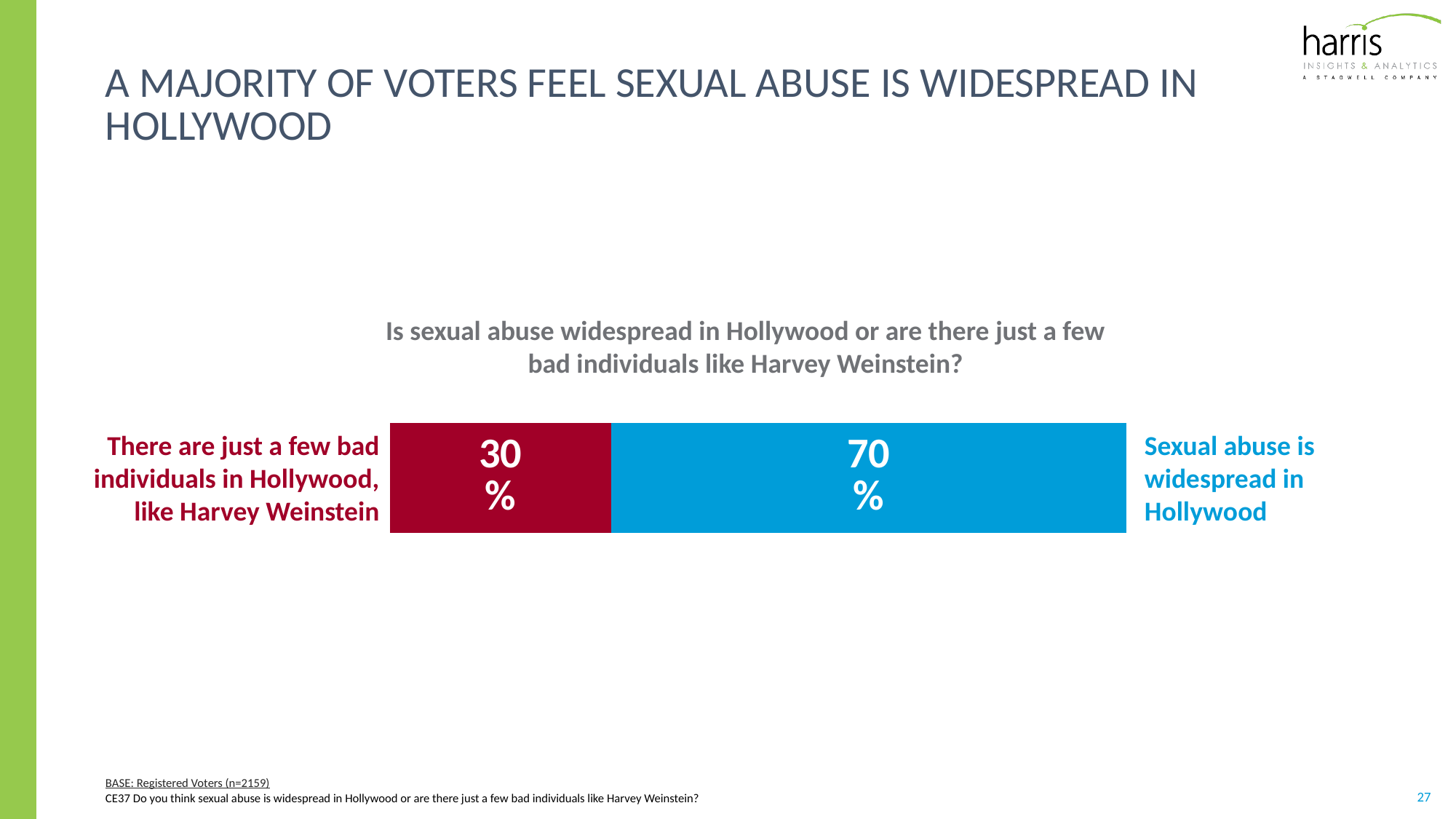
What percentage of voters say sexual abuse is widespread in Hollywood? 70% What question is the chart titled with? Is sexual abuse widespread in Hollywood or are there just a few bad individuals like Harvey Weinstein? What kind of chart is shown on the slide? bar chart What is the difference in percentage points between the 'widespread' response and the 'few bad individuals' response? 40 Which response received the larger share of voters? Sexual abuse is widespread in Hollywood What colour is the segment representing 'Sexual abuse is widespread in Hollywood'? blue What percentage of voters say there are just a few bad individuals in Hollywood, like Harvey Weinstein? 30% How many response categories are shown in the chart? 2 What do the two segments of the bar add up to? 100% Which response received the smaller share of voters? There are just a few bad individuals in Hollywood, like Harvey Weinstein Is the share for 'Sexual abuse is widespread in Hollywood' larger or smaller than the share for 'There are just a few bad individuals in Hollywood'? larger